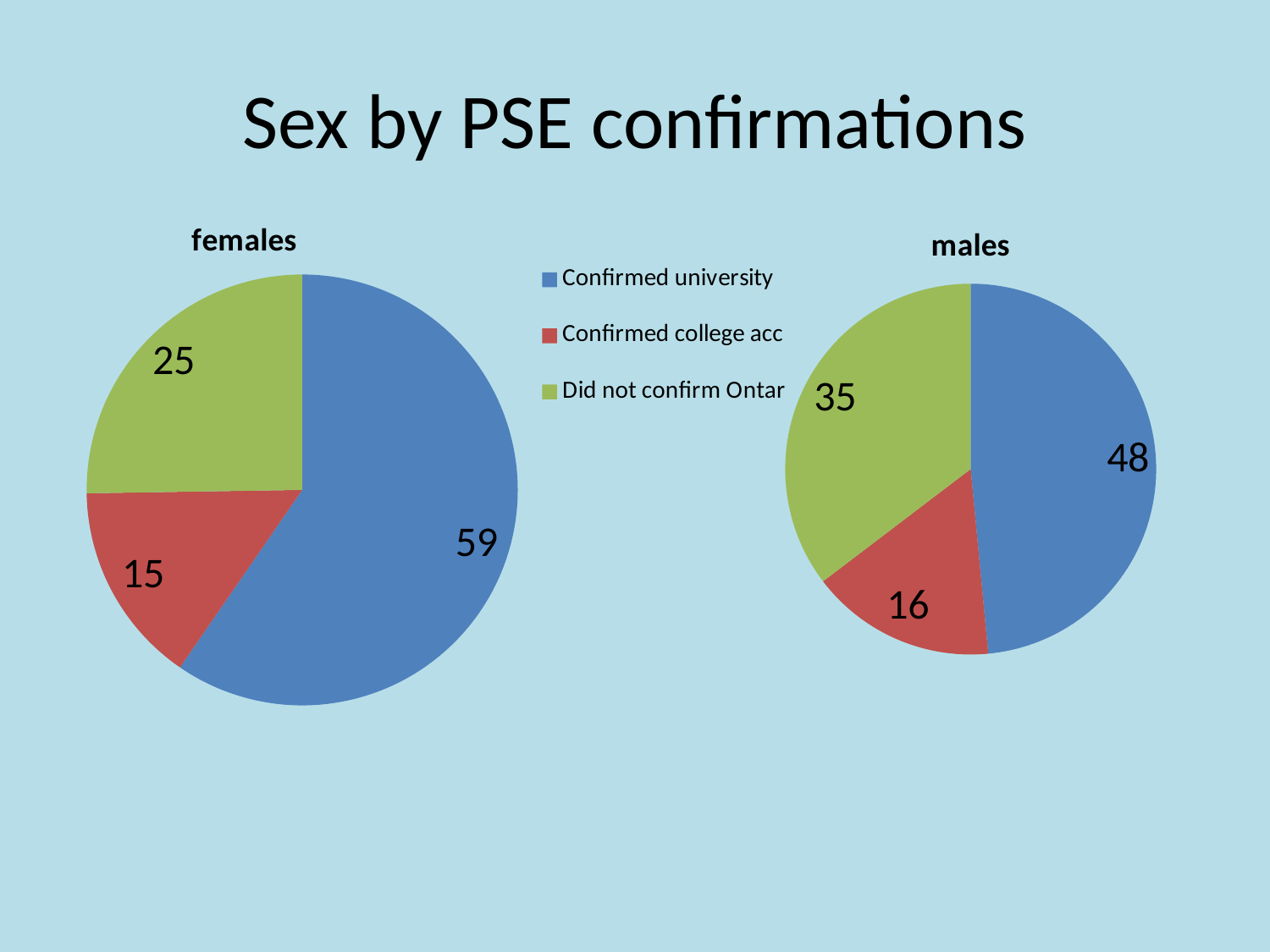
What is the total of the three values shown in the males pie chart? 99 In the males pie chart, which category has the largest slice? Confirmed university What colour represents Confirmed college acc in the pie charts? red In the females pie chart, which category has the smallest slice? Confirmed college acc In the males pie chart, what is the value for Confirmed college acc? 16 In the females pie chart, what is the value for Confirmed university? 59 In the females pie chart, what is the difference between the Confirmed university value and the Did not confirm Ontar value? 34 In the males pie chart, what is the value for Did not confirm Ontar? 35 Which is larger: the Did not confirm Ontar value for females or for males? males How many entries does the legend list? 3 What type of chart is used for the females and males data? pie chart How many slices does the females pie chart have? 3